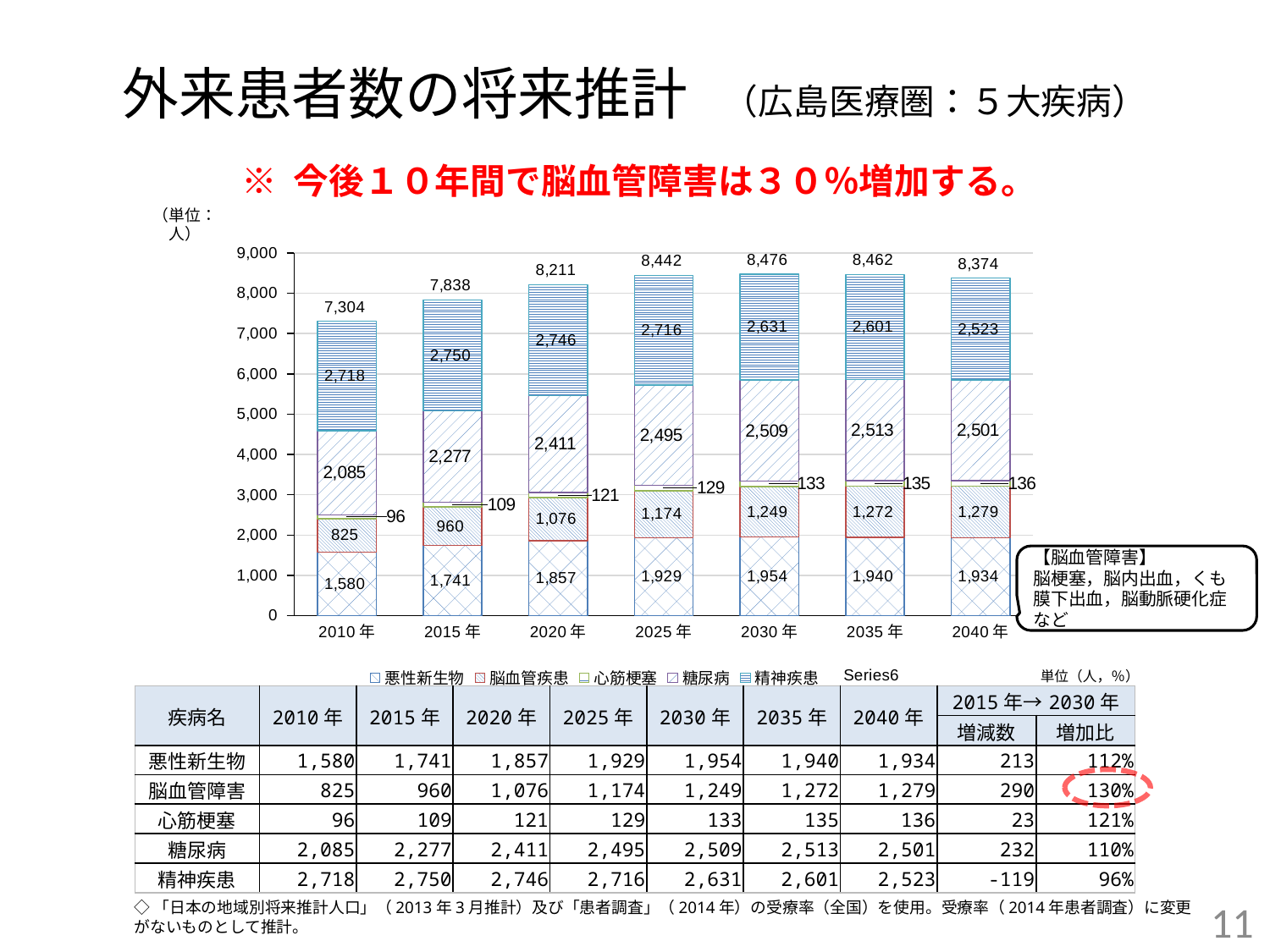
In 2010年, which is larger: the value for 糖尿病 or the value for 精神疾患? 精神疾患 What is the value for 悪性新生物 in 2010年? 1,580 What kind of chart is shown on the slide? stacked bar chart Do the values for 心筋梗塞 rise or fall from 2010年 to 2040年? rise How many years (categories) are plotted along the x axis of the chart? 7 What is the value for 精神疾患 in 2040年? 2,523 What is the difference between the 糖尿病 value in 2020年 and in 2010年? 326 Which year has the lowest stacked bar total? 2010年 What is the value for 心筋梗塞 in 2025年? 129 How many series does the chart legend list? 6 Which year has the highest stacked bar total? 2030年 What is the total of the stacked bar for 2030年? 8,476